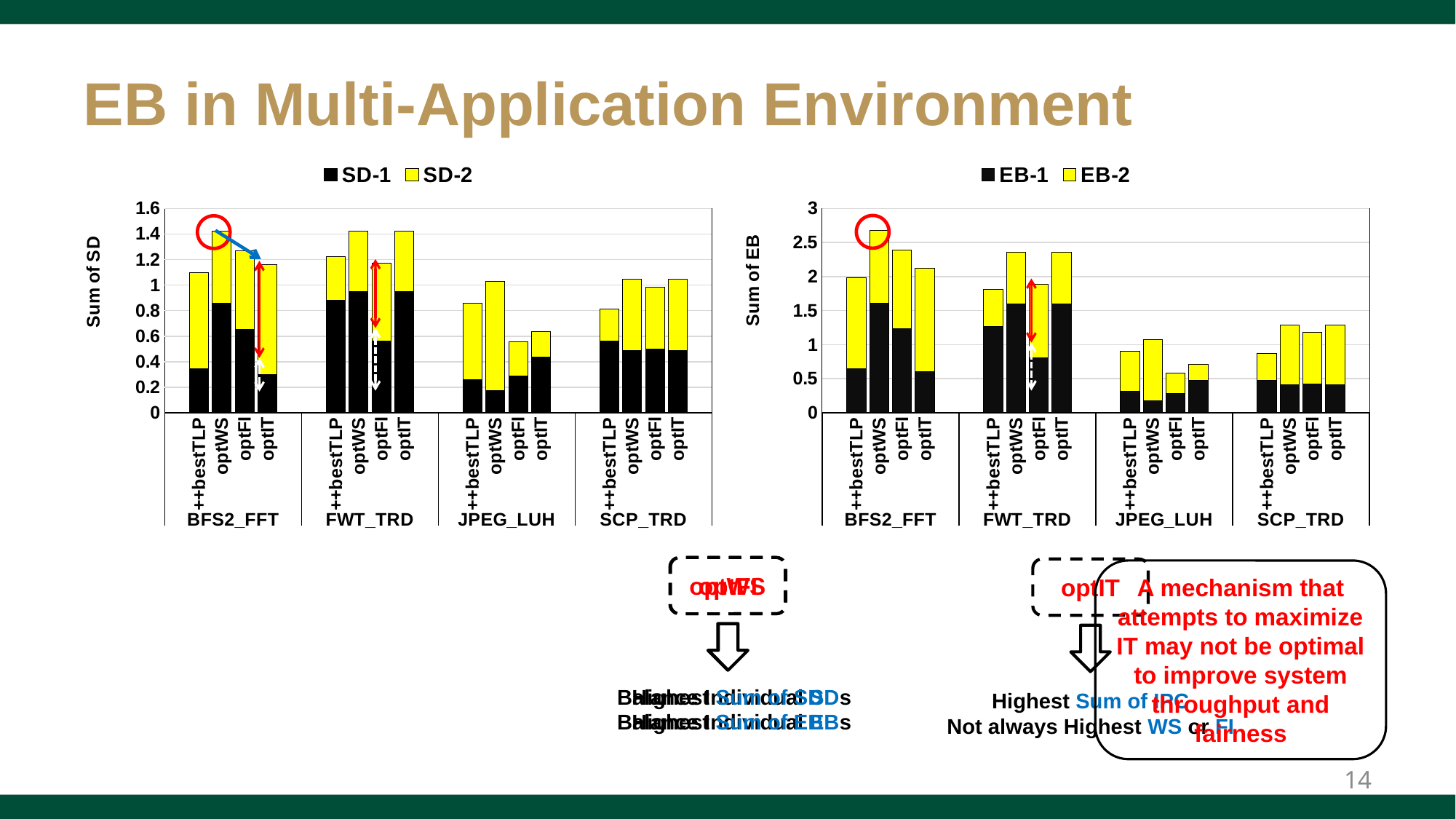
In the left chart (Sum of SD), is the total for ++bestTLP in BFS2_FFT greater or less than 1? greater How many series does the legend of the right chart (Sum of EB) list? 2 In the left chart (Sum of SD), which has the larger total: optWS in BFS2_FFT or optIT in BFS2_FFT? optWS in BFS2_FFT In the right chart (Sum of EB), which has the larger total: optWS in BFS2_FFT or optWS in FWT_TRD? optWS in BFS2_FFT How many application pair groups are shown on the x axis of the right chart (Sum of EB)? 4 In the left chart (Sum of SD), is the total for ++bestTLP in JPEG_LUH greater or less than 1? less What kind of chart is the left chart (Sum of SD)? stacked bar chart What are the legend entries of the left chart (Sum of SD)? SD-1 and SD-2 In the right chart (Sum of EB), is the total for optWS in BFS2_FFT greater or less than 2.5? greater How many stacked bars are plotted in the left chart (Sum of SD)? 16 In the right chart (Sum of EB), which bar has the highest total? optWS in BFS2_FFT